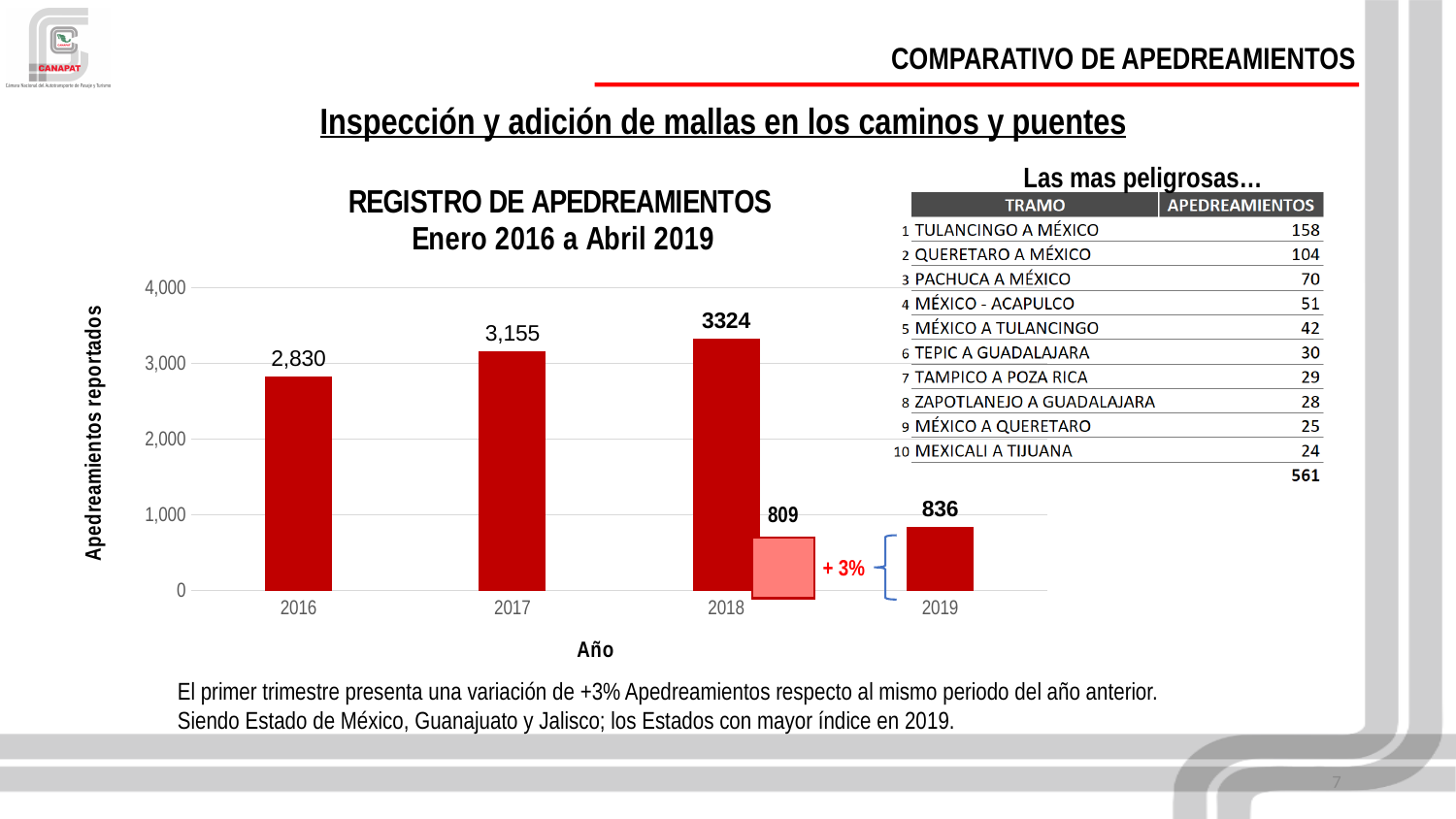
What is the value for 2018 in the REGISTRO DE APEDREAMIENTOS chart? 3324 In the REGISTRO DE APEDREAMIENTOS chart, what is the difference between the 2017 and 2016 values? 325 What kind of chart is the REGISTRO DE APEDREAMIENTOS chart? Bar chart In the REGISTRO DE APEDREAMIENTOS chart, what is the difference between the 2019 value (836) and the 2018 partial value labelled 809? 27 Which year has the lowest bar in the REGISTRO DE APEDREAMIENTOS chart? 2019 How many years are shown on the x axis of the REGISTRO DE APEDREAMIENTOS chart? 4 What is the label of the y axis in the REGISTRO DE APEDREAMIENTOS chart? Apedreamientos reportados In the REGISTRO DE APEDREAMIENTOS chart, which is larger, the value for 2016 or the value for 2017? 2017 What is the value for 2016 in the REGISTRO DE APEDREAMIENTOS chart? 2,830 What is the value for 2019 in the REGISTRO DE APEDREAMIENTOS chart? 836 Which year has the highest bar in the REGISTRO DE APEDREAMIENTOS chart? 2018 What is the value for 2017 in the REGISTRO DE APEDREAMIENTOS chart? 3,155